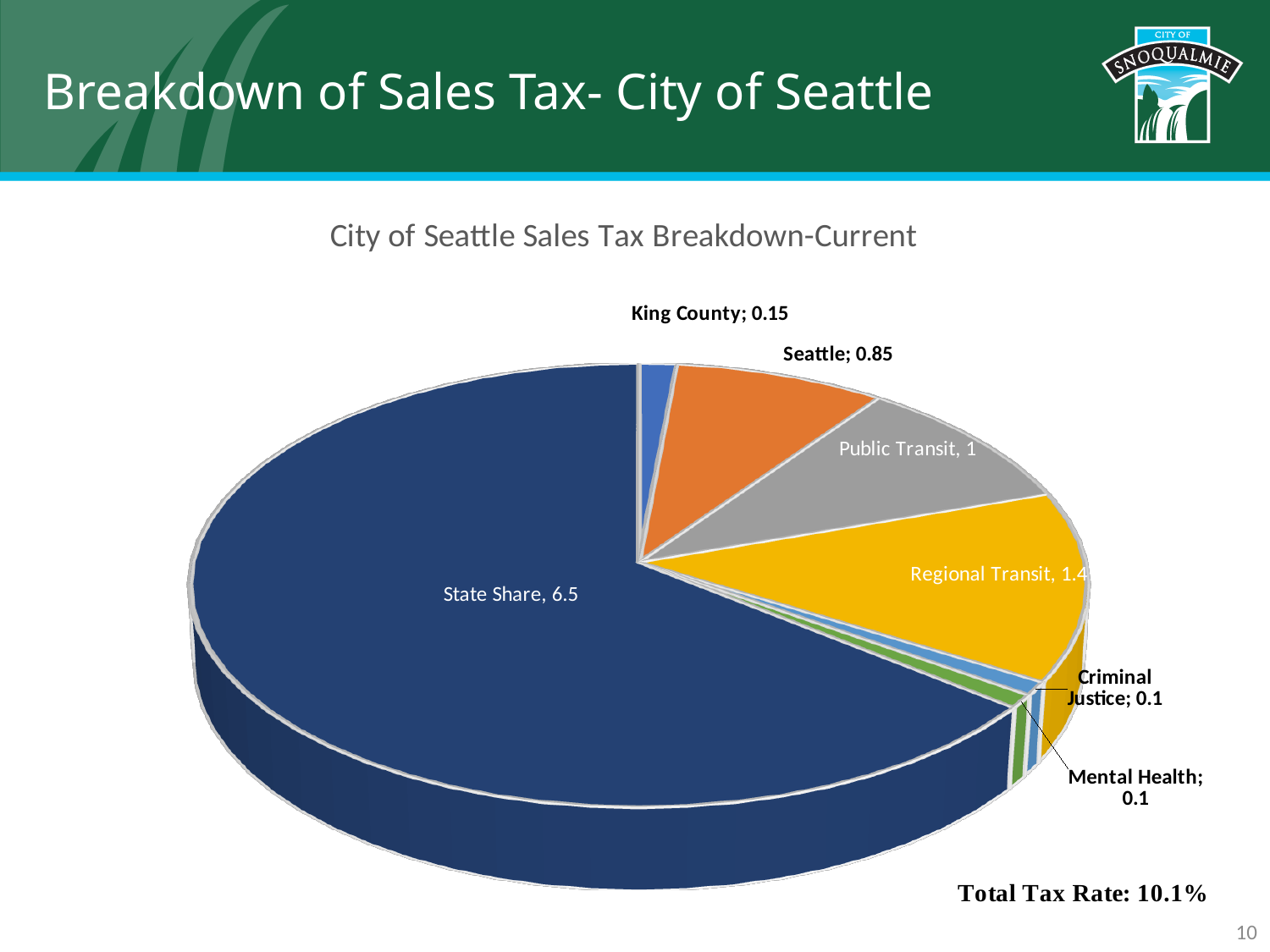
What is the title of the chart? City of Seattle Sales Tax Breakdown-Current Which is larger, the Seattle slice or the Public Transit slice? Public Transit What share of the total tax rate does the State Share slice represent? 64.4% What is the value for King County? 0.15 What total tax rate is stated on the slide? 10.1% Which category has the largest slice of the pie? State Share What is the value for Regional Transit? 1.4 What type of chart is shown on the slide? Pie chart What is the value of the State Share slice? 6.5 How many slices does the pie chart have? 7 What is the value for Seattle? 0.85 What is the difference between the Regional Transit and Public Transit values? 0.4